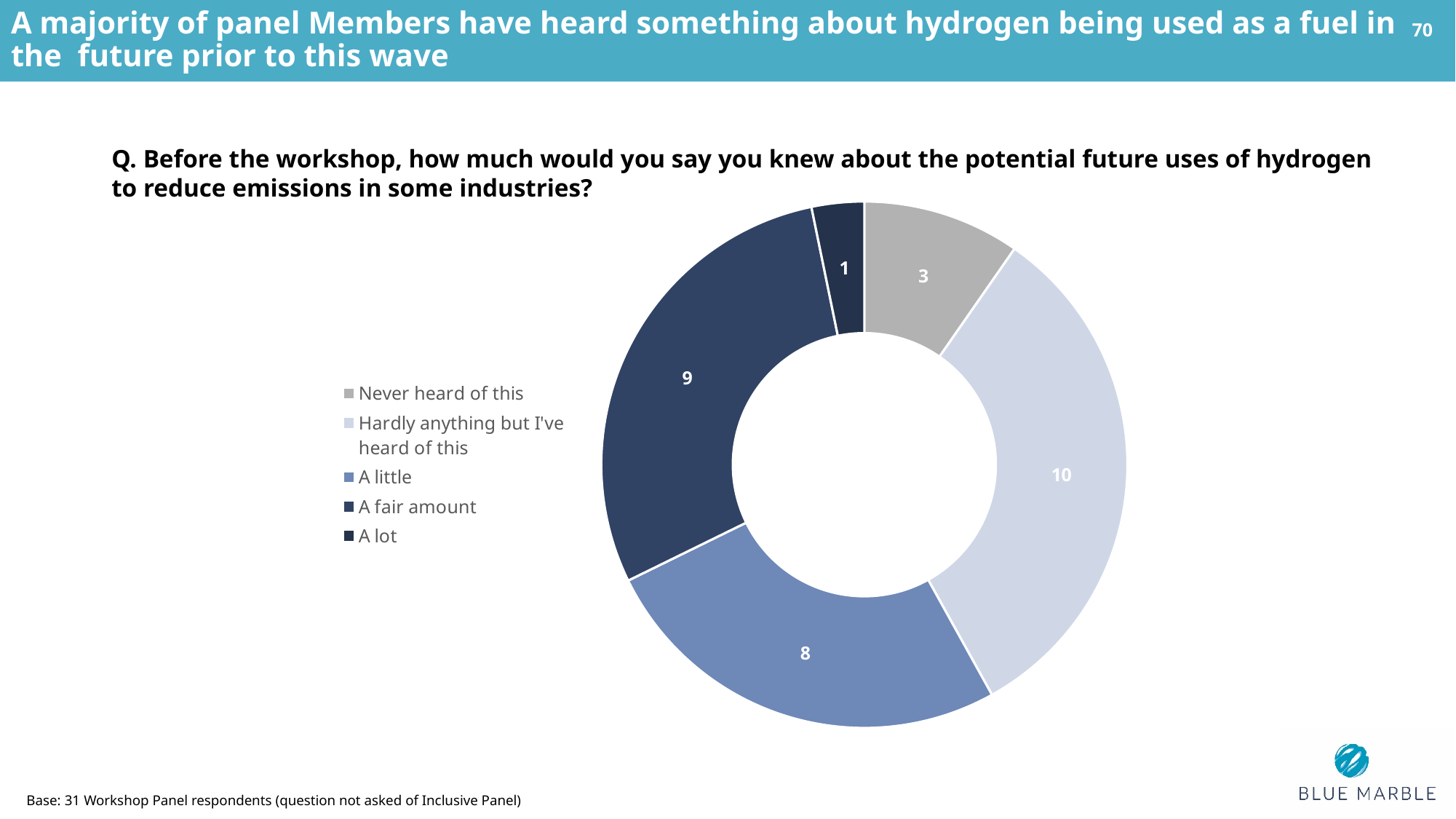
Which is larger, the value for 'A little' or the value for 'Never heard of this'? A little What is the value for 'Never heard of this'? 3 How many categories does the chart show? 5 What is the value for 'A fair amount'? 9 How many respondents said 'Hardly anything but I've heard of this'? 10 Which legend entry is shown in grey? Never heard of this Which category has the smallest slice? A lot What is the difference between the values for 'A fair amount' and 'A little'? 1 Which category has the largest slice? Hardly anything but I've heard of this What kind of chart is shown on the slide? doughnut chart What is the total of all the slices in the chart? 31 What is the value for 'A lot'? 1